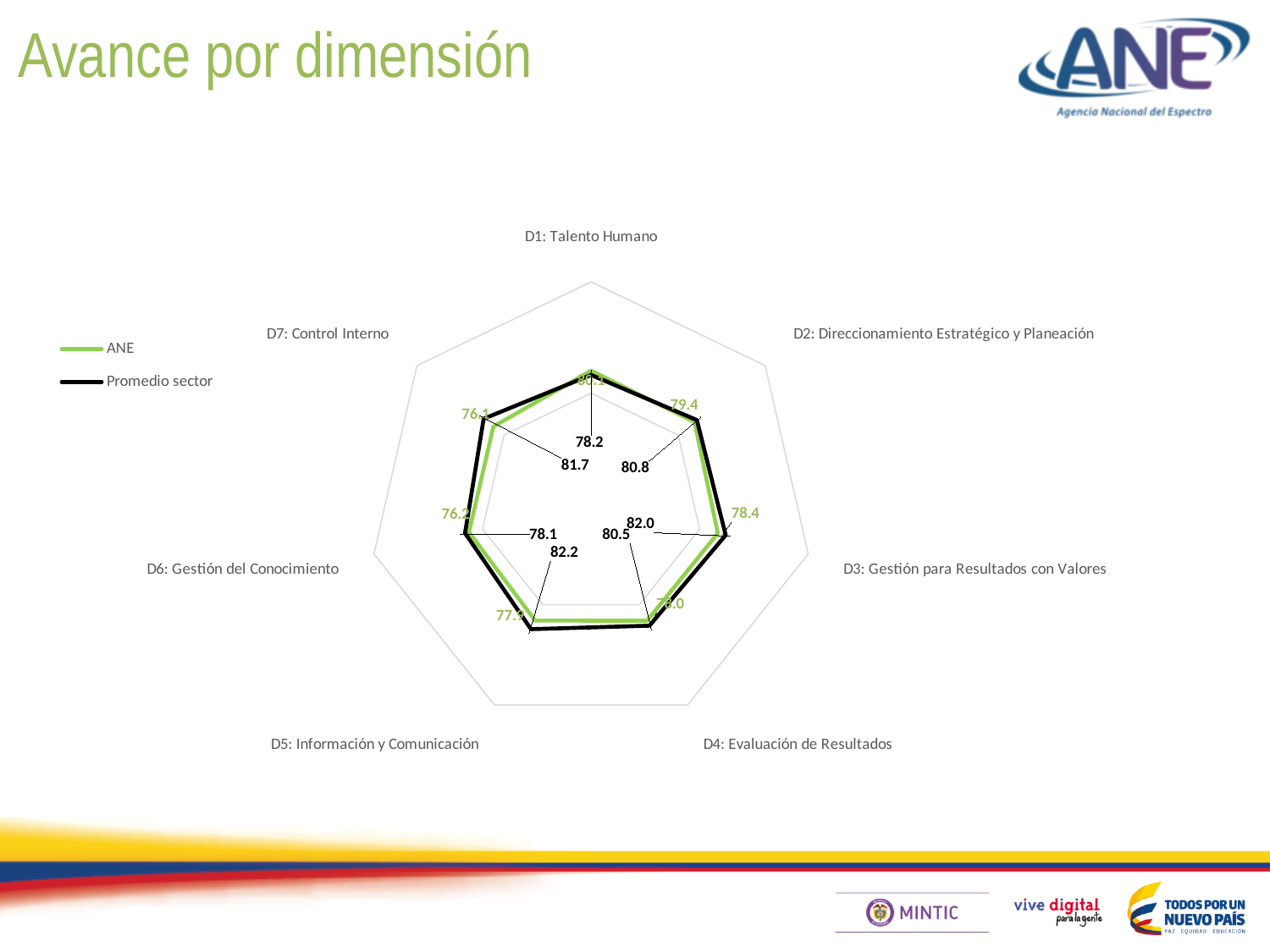
What are the two series named in the legend? ANE and Promedio sector How many dimensions (categories) are plotted on the radar chart? 7 What kind of chart is shown on the slide? Radar chart What is the Promedio sector value for D5: Información y Comunicación? 82.2 What is the Promedio sector value for D6: Gestión del Conocimiento? 78.1 What is the ANE value for D7: Control Interno? 76.1 What is the Promedio sector value for D7: Control Interno? 81.7 What is the difference between the Promedio sector and ANE values for D7: Control Interno? 5.6 What is the ANE value for D3: Gestión para Resultados con Valores? 78.4 How many series does the legend list? 2 What is the ANE value for D2: Direccionamiento Estratégico y Planeación? 79.4 Which series has the larger value for D7: Control Interno, ANE or Promedio sector? Promedio sector